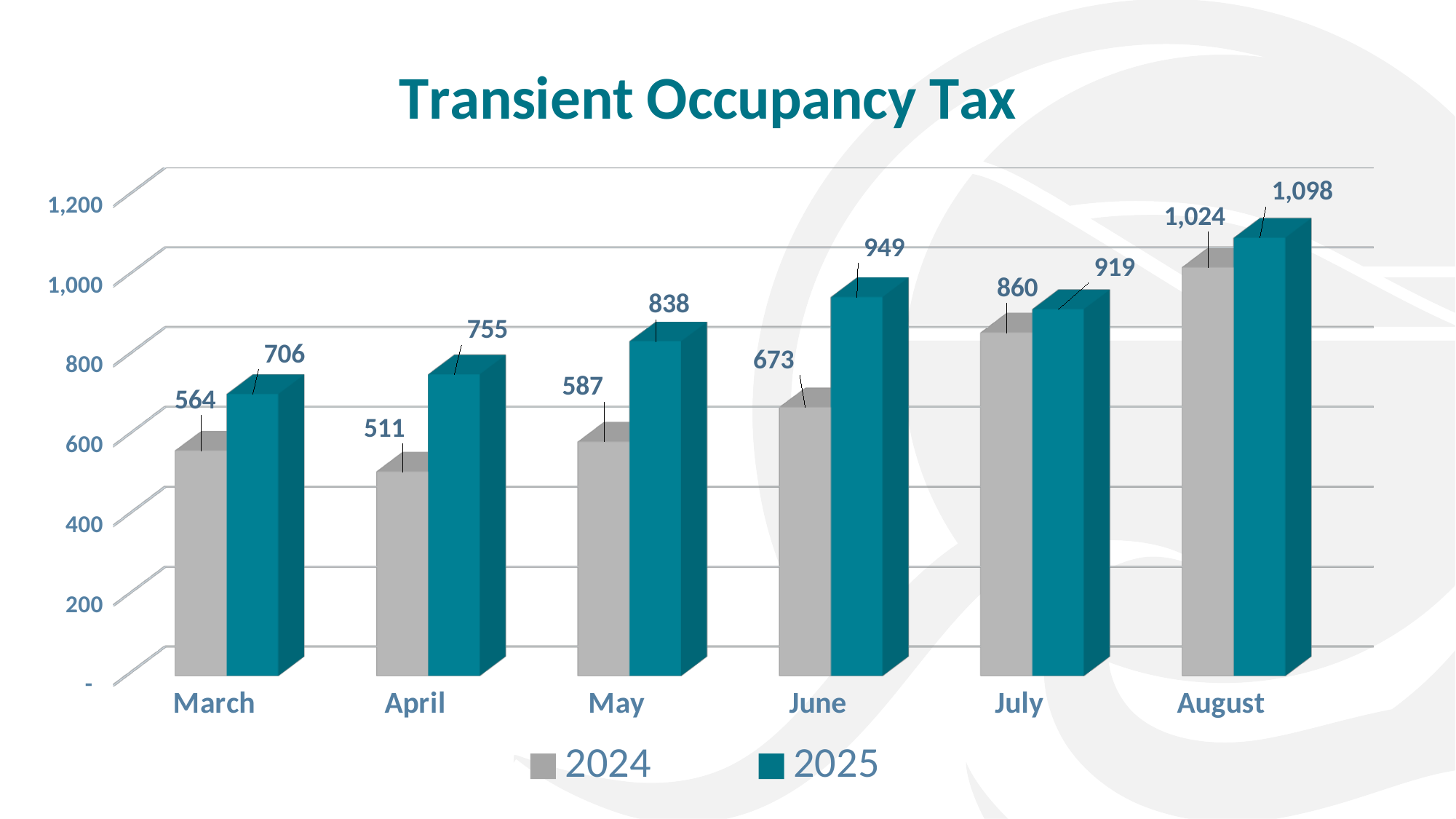
What kind of chart is shown on the slide? bar chart What is the Transient Occupancy Tax value for 2025 in August? 1,098 What is the Transient Occupancy Tax value for 2024 in April? 511 What is the difference between the 2025 and 2024 values for May? 251 Do the 2025 values rise or fall from March to August? rise How many months are shown on the x axis? 6 Which month has the lowest 2025 value? March How many series does the legend list? 2 What is the Transient Occupancy Tax value for 2025 in June? 949 Which is larger, the 2024 value for July or the 2025 value for April? 2024 value for July Is the 2024 value for June greater or less than 800? less Which month has the highest 2024 value? August